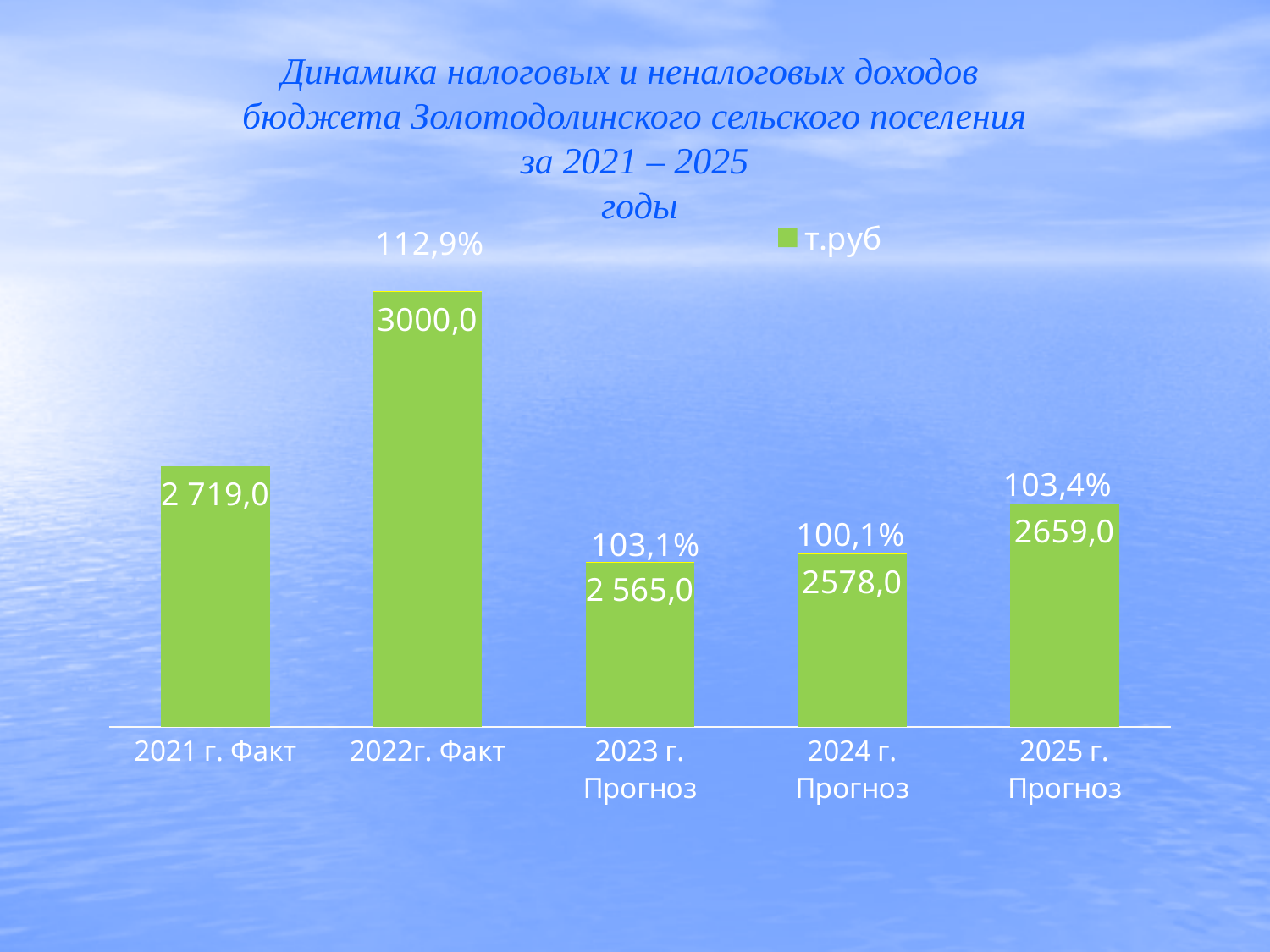
How many categories are shown on the x axis? 5 What is the value for 2021 г. Факт? 2 719,0 Which category has the highest value? 2022г. Факт What kind of chart is shown on the slide? Bar chart Which is larger, the value for 2021 г. Факт or the value for 2025 г. Прогноз? 2021 г. Факт What is the difference between the values for 2022г. Факт and 2021 г. Факт? 281,0 What entry does the legend list? т.руб What is the difference between the values for 2025 г. Прогноз and 2024 г. Прогноз? 81,0 What percentage label is shown above the 2025 г. Прогноз bar? 103,4% Which category has the lowest value? 2023 г. Прогноз What is the value for 2024 г. Прогноз? 2578,0 What is the value for 2022г. Факт? 3000,0